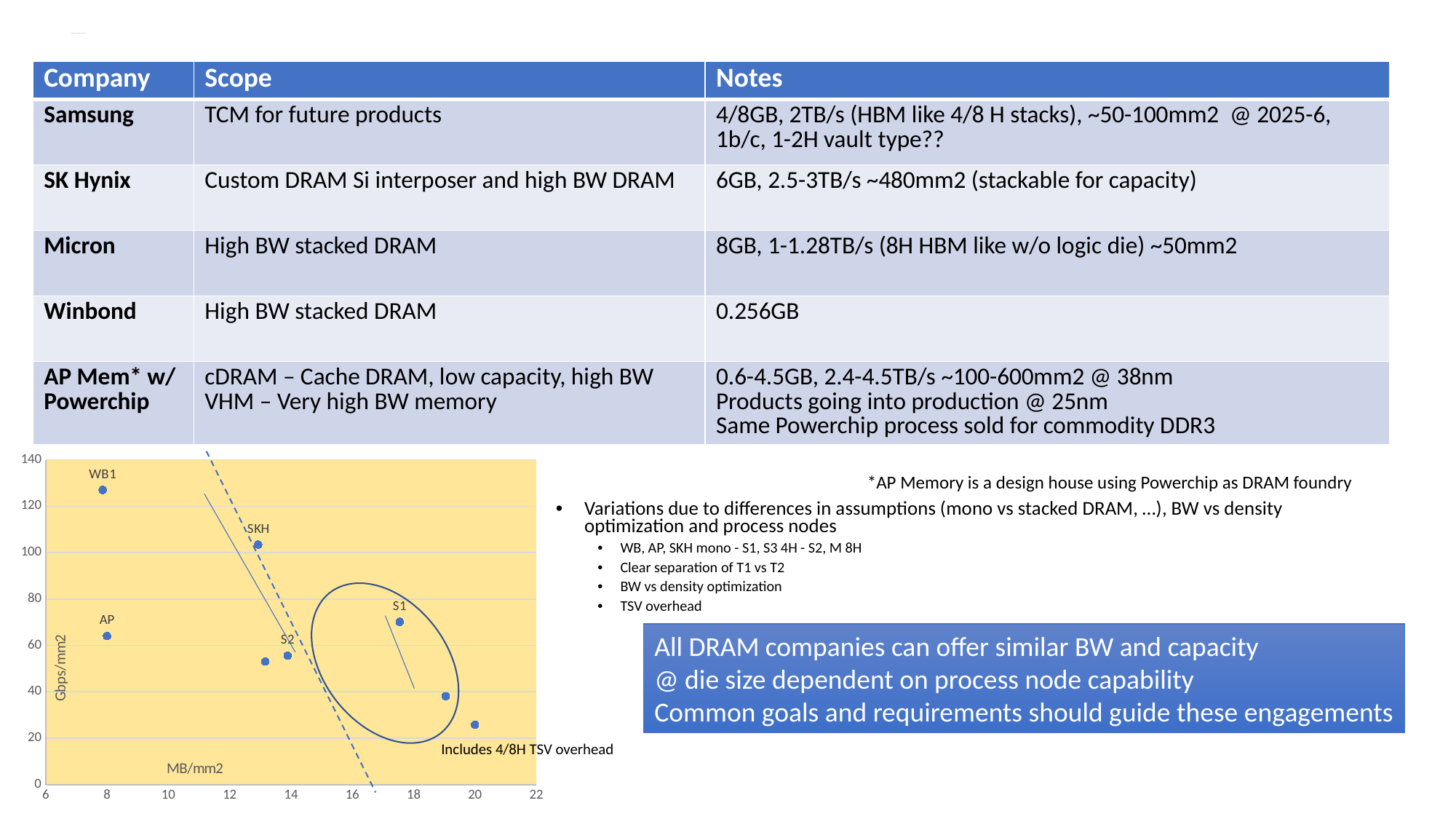
Is the Gbps/mm2 value for S2 greater or less than 60? less On the scatter chart, which point has the higher Gbps/mm2 value, WB1 or SKH? WB1 How many data points are plotted on the scatter chart? 8 Do the Gbps/mm2 values on the scatter chart generally rise or fall as MB/mm2 increases? fall Is the Gbps/mm2 value for SKH greater or less than 80? greater On the scatter chart, which point has the higher Gbps/mm2 value, S1 or S2? S1 What kind of chart is shown at the bottom left of the slide? scatter chart Is the Gbps/mm2 value for WB1 greater or less than 120? greater Which labeled point on the scatter chart has the highest Gbps/mm2 value? WB1 What is the label on the vertical axis of the scatter chart? Gbps/mm2 Of the labeled points on the scatter chart, which has the lowest Gbps/mm2 value? S2